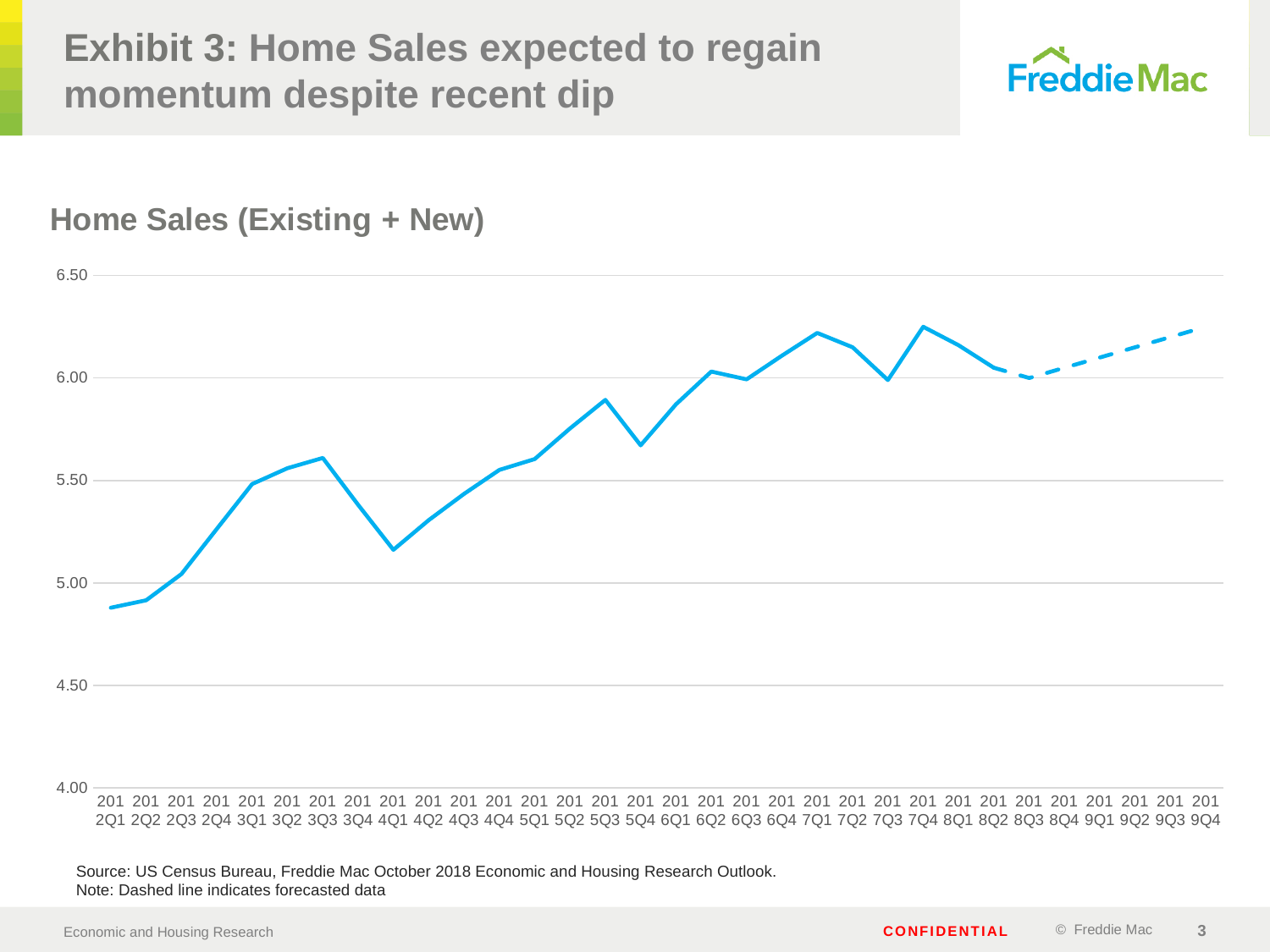
Is the value for 2019Q4 greater or less than 6.00? greater According to the note, what does the dashed portion of the line indicate? forecasted data What kind of chart is shown on the slide? line chart How many quarterly points are plotted along the x axis? 32 Is the value for 2015Q3 greater or less than 6.00? less Is the value for 2014Q1 greater or less than 5.00? greater Overall, do the values rise or fall from 2012Q1 to 2019Q4? rise Which quarter has the lowest value on the chart? 2012Q1 Which is larger, the value for 2012Q1 or the value for 2019Q4? 2019Q4 What is the title of the chart? Home Sales (Existing + New)